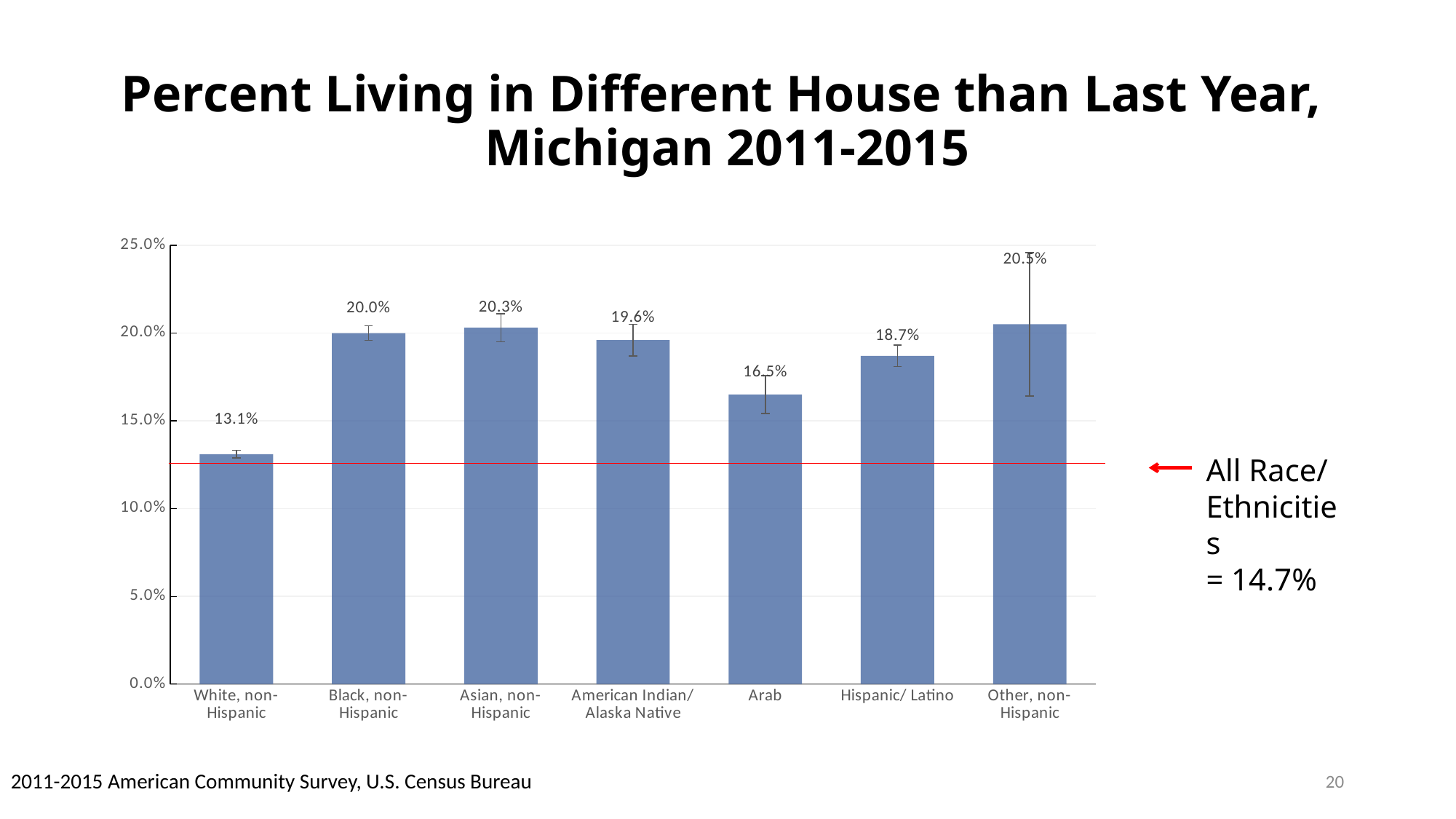
What is the difference between the values for Black, non-Hispanic and White, non-Hispanic? 6.9% What is the value shown for Arab? 16.5% What is the percent living in a different house than last year for White, non-Hispanic? 13.1% Which is larger, the value for Asian, non-Hispanic or the value for Black, non-Hispanic? Asian, non-Hispanic What is the value shown for American Indian/ Alaska Native? 19.6% How many race/ethnicity categories are shown on the x axis? 7 Which category has the highest value? Other, non-Hispanic Which category has the lowest value? White, non-Hispanic Is the value for Arab greater or less than 15.0%? greater What value does the red horizontal line labeled All Race/Ethnicities represent? 14.7% What is the value shown for Hispanic/ Latino? 18.7% What kind of chart is shown on the slide? bar chart